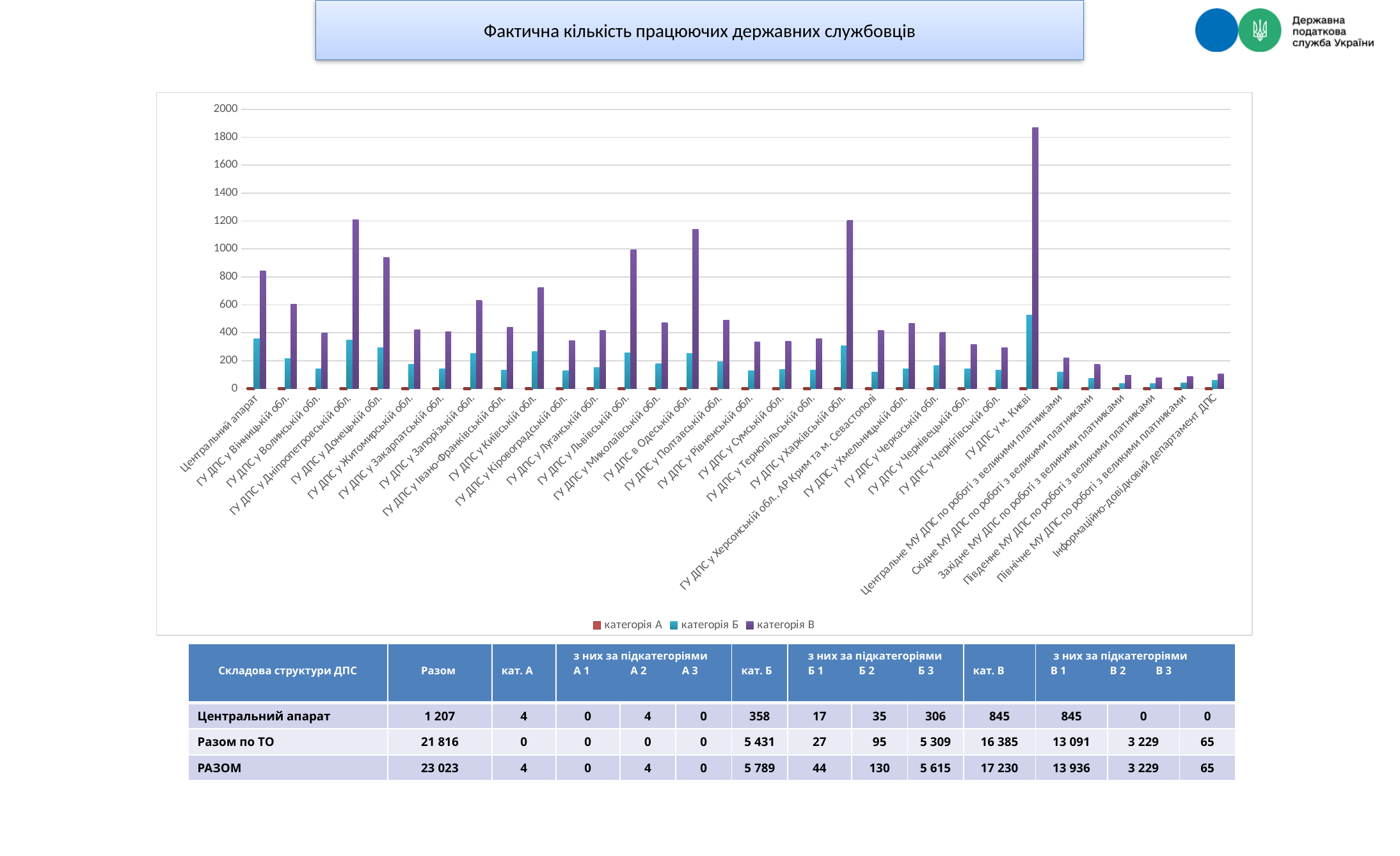
Is the value of категорія Б for ГУ ДПС у Волинській обл. greater or less than 200? less Which series are listed in the chart legend? категорія А, категорія Б, категорія В Which is larger for категорія В: ГУ ДПС у Харківській обл. or ГУ ДПС у Львівській обл.? ГУ ДПС у Харківській обл. Is the value of категорія В for ГУ ДПС у Дніпропетровській обл. greater or less than 1000? greater Is the value of категорія В for ГУ ДПС у Вінницькій обл. greater or less than 400? greater What type of chart is shown on the slide? bar chart Which category has the highest value for категорія В? ГУ ДПС у м. Києві Which category has the highest value for категорія Б? ГУ ДПС у м. Києві How many series does the chart legend list? 3 Which is larger for категорія В: ГУ ДПС у Донецькій обл. or ГУ ДПС у Житомирській обл.? ГУ ДПС у Донецькій обл. What is the title shown above the chart? Фактична кількість працюючих державних службовців